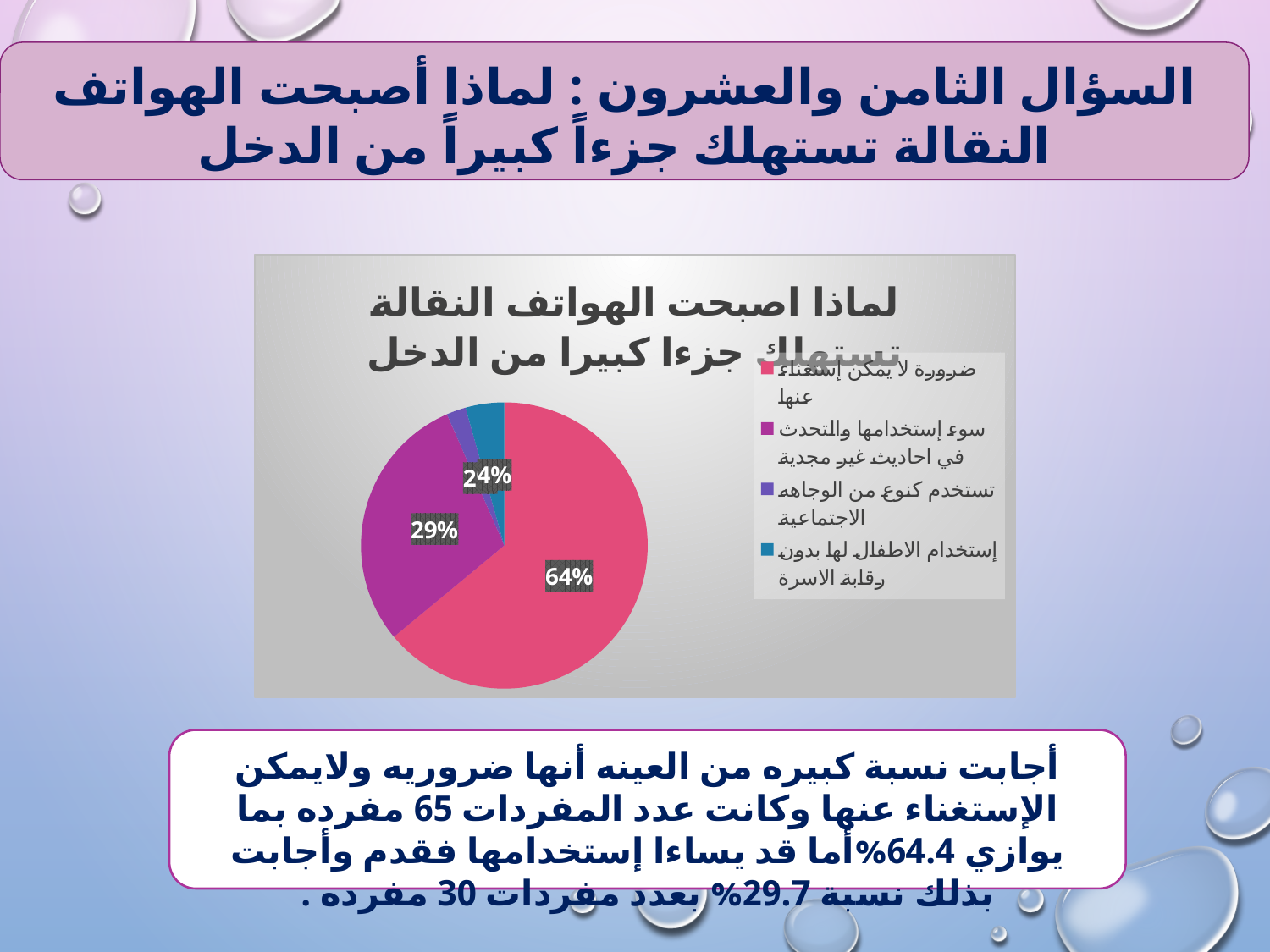
Which category has the largest slice of the pie? ضرورة لا يمكن إستغناء عنها What colour is the largest slice of the pie? Pink Which is larger: the slice for 'ضرورية لا يمكن الاستغناء عنها' or the slice for 'سوء إستخدامها والتحدث في احاديث غير مجدية'? ضرورة لا يمكن إستغناء عنها What is the title of the chart? لماذا اصبحت الهواتف النقالة تستهلك جزءا كبيرا من الدخل How many categories does the legend list? 4 What share of the pie does the slice 'ضرورية لا يمكن الاستغناء عنها' represent? 64% What kind of chart is shown on the slide? Pie chart What share of the pie does the slice 'سوء إستخدامها والتحدث في احاديث غير مجدية' represent? 29% Which is larger: the slice for 'إستخدام الاطفال لها بدون رقابة الاسرة' or the slice for 'ضرورية لا يمكن الاستغناء عنها'? ضرورة لا يمكن إستغناء عنها What is the difference in percentage points between the 'ضرورية لا يمكن الاستغناء عنها' slice and the 'سوء إستخدامها والتحدث في احاديث غير مجدية' slice? 35 percentage points